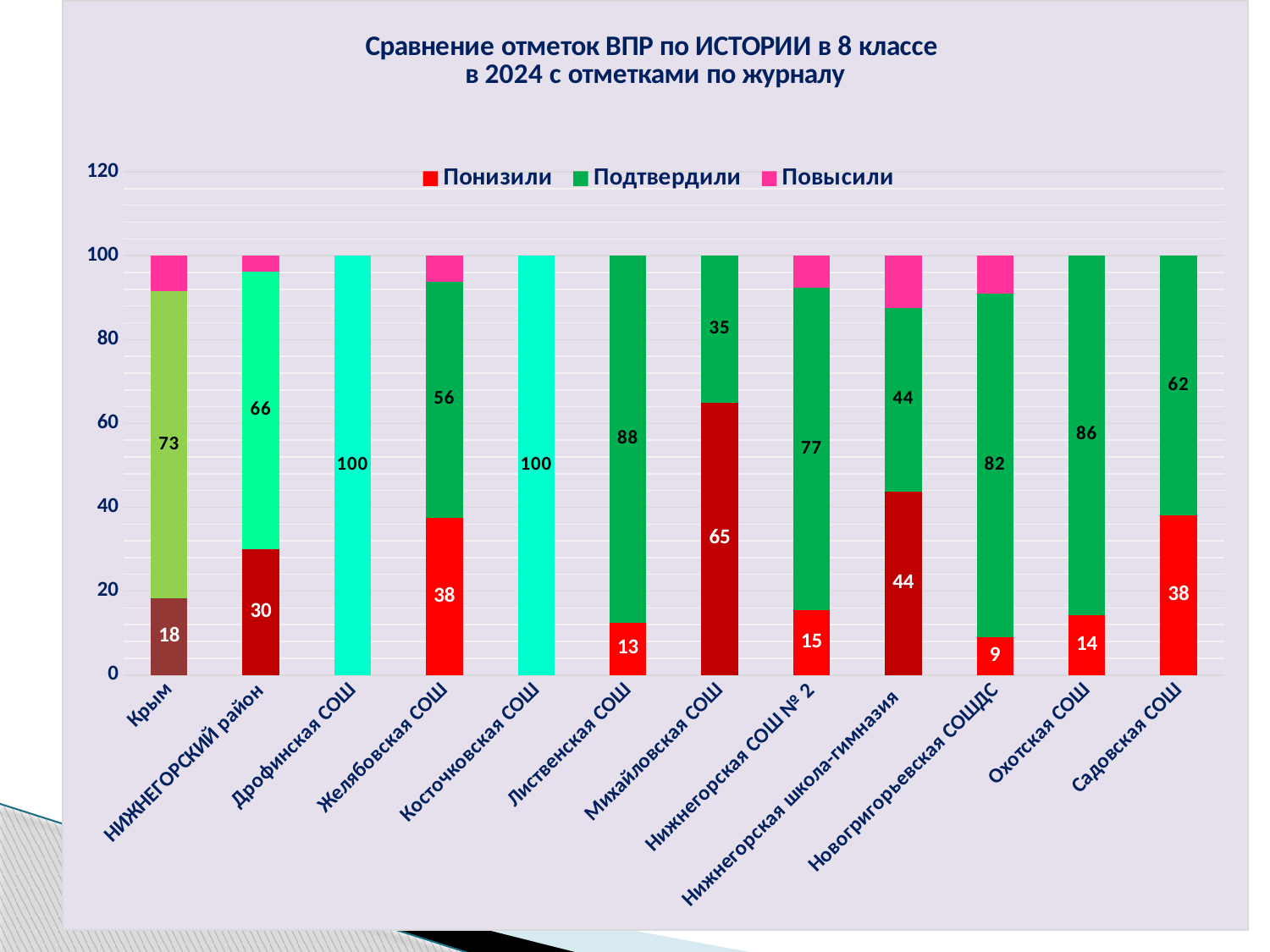
What kind of chart is shown on the slide? stacked bar chart What is the Понизили value for Михайловская СОШ? 65 Which category has the lowest Подтвердили value? Михайловская СОШ How many categories are shown on the x axis? 12 Is the Повысили value for Нижнегорская школа-гимназия greater or less than 20? less Which category has the highest Понизили value? Михайловская СОШ What is the Подтвердили value for Охотская СОШ? 86 How many series does the legend list? 3 What is the total of the stacked bar for Садовская СОШ? 100 What is the difference between the Понизили and Подтвердили values for Михайловская СОШ? 30 Which is larger: the Подтвердили value for Лиственская СОШ or for Охотская СОШ? Лиственская СОШ What is the Понизили value for Новогригорьевская СОШДС? 9